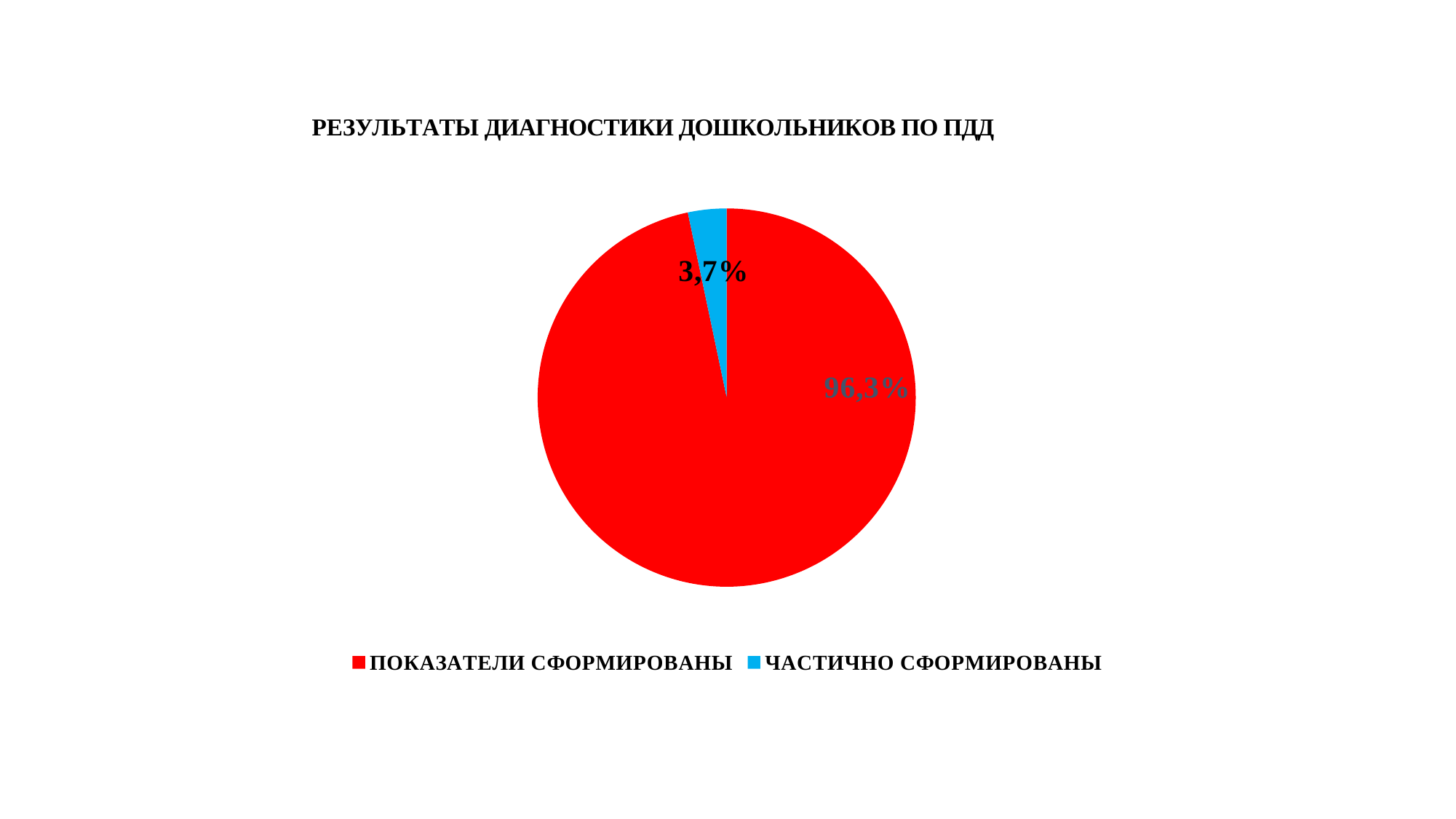
What is the difference in percentage points between the ПОКАЗАТЕЛИ СФОРМИРОВАНЫ slice and the ЧАСТИЧНО СФОРМИРОВАНЫ slice? 92,6% Which category has the smallest slice of the pie? ЧАСТИЧНО СФОРМИРОВАНЫ What kind of chart is shown on the slide? pie chart What is the total of the two slice percentages shown on the pie? 100% How many entries does the legend list? 2 What share of the pie is labelled for ЧАСТИЧНО СФОРМИРОВАНЫ? 3,7% Which category has the largest slice of the pie? ПОКАЗАТЕЛИ СФОРМИРОВАНЫ What is the title of the chart? РЕЗУЛЬТАТЫ ДИАГНОСТИКИ ДОШКОЛЬНИКОВ ПО ПДД What colour is the slice for ЧАСТИЧНО СФОРМИРОВАНЫ? blue What share of the pie is labelled for ПОКАЗАТЕЛИ СФОРМИРОВАНЫ? 96,3% Which is larger: the slice for ПОКАЗАТЕЛИ СФОРМИРОВАНЫ or the slice for ЧАСТИЧНО СФОРМИРОВАНЫ? ПОКАЗАТЕЛИ СФОРМИРОВАНЫ How many slices does the pie chart have? 2